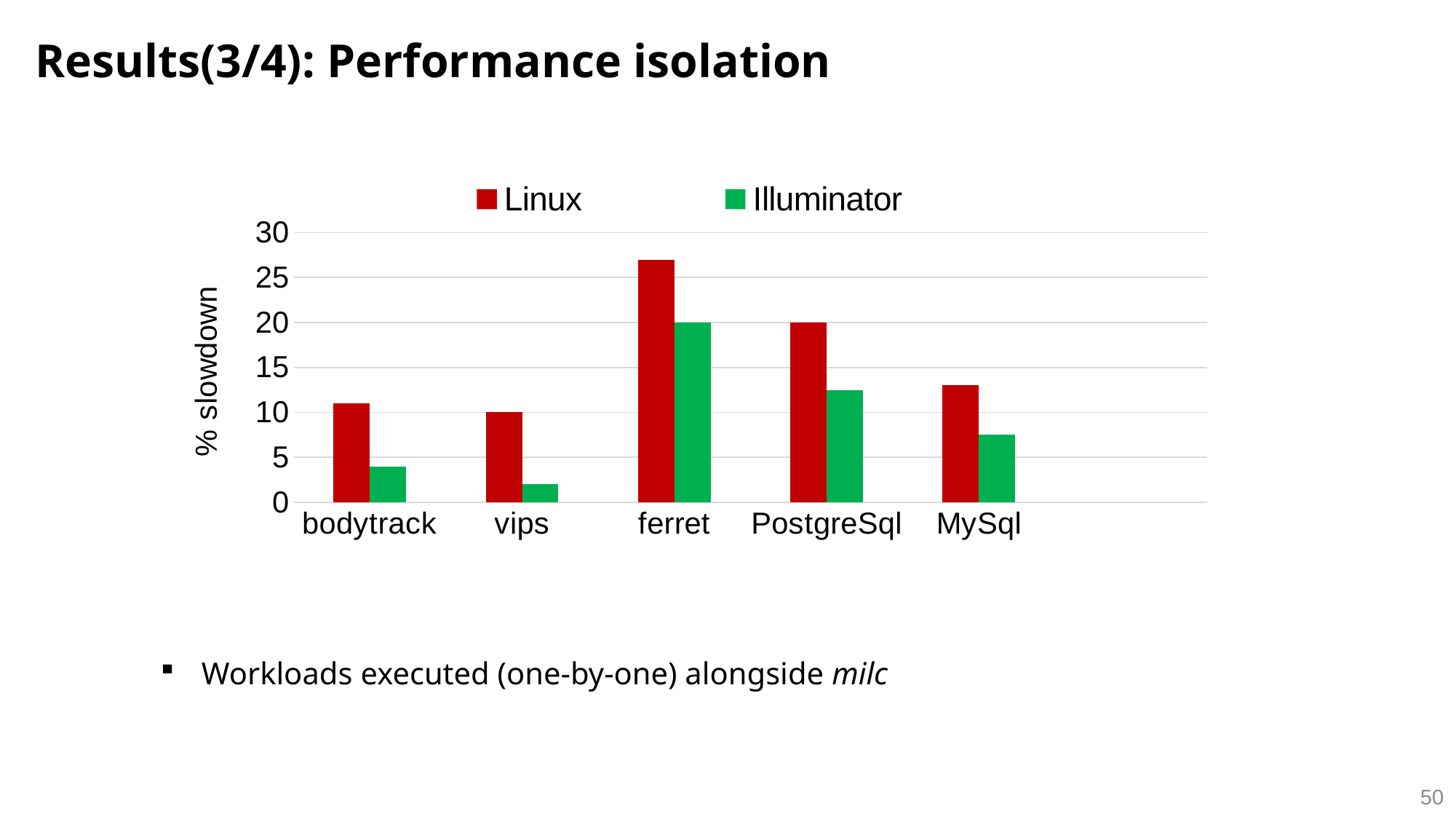
Which workload has the highest Linux % slowdown? ferret Which workload has the lowest Illuminator % slowdown? vips Is the Illuminator % slowdown for bodytrack greater or less than 5? less Is the Illuminator % slowdown for MySql greater or less than 10? less Is the Linux % slowdown for PostgreSql greater or less than 15? greater How many workloads are shown on the x axis? 5 What kind of chart is shown on the slide? bar chart How many series does the legend list? 2 Which series is drawn in green? Illuminator What is the label of the y axis? % slowdown For ferret, which series shows the larger % slowdown, Linux or Illuminator? Linux